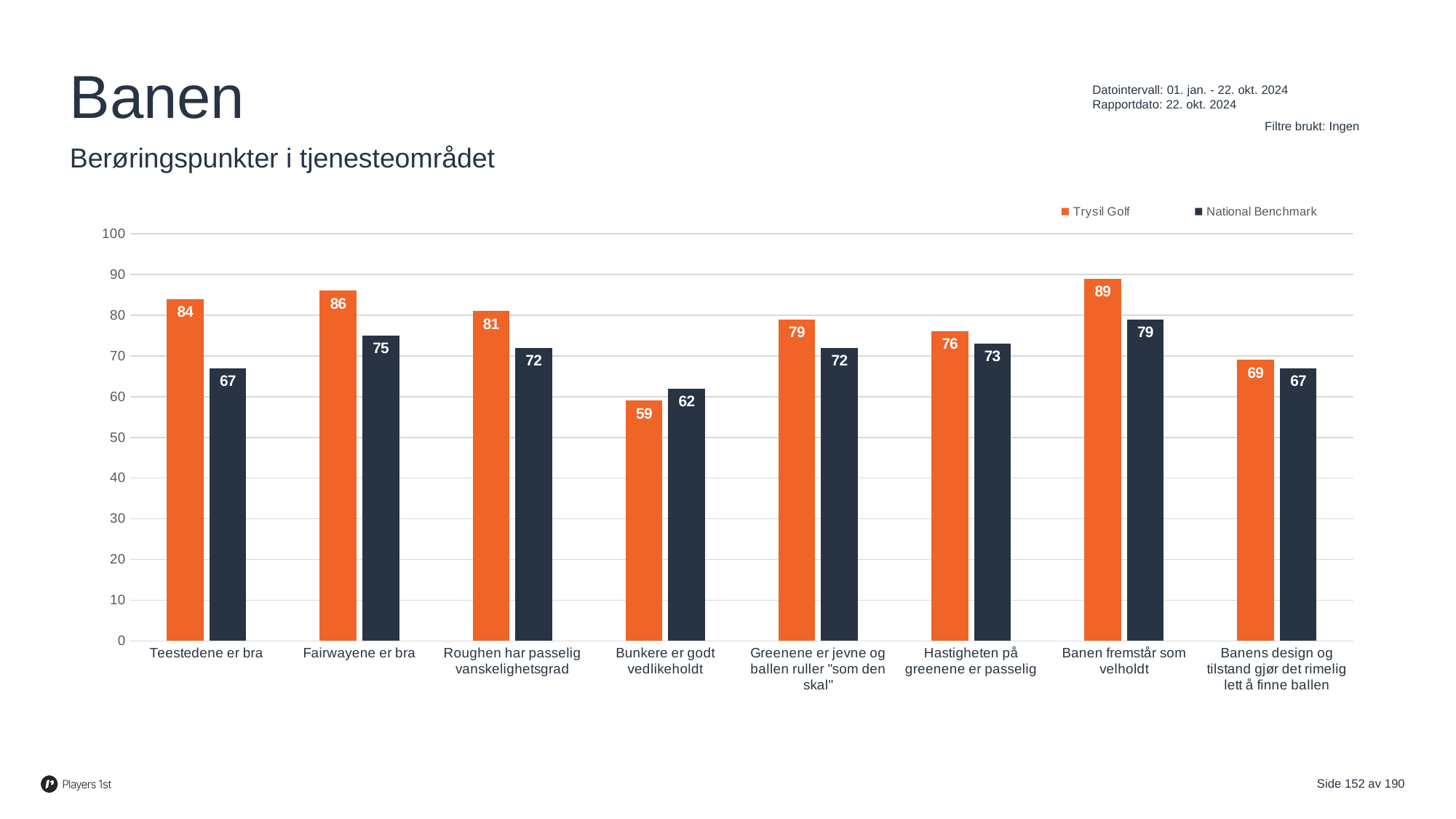
What is the difference between the Trysil Golf and National Benchmark values for "Teestedene er bra"? 17 Is the Trysil Golf value for "Roughen har passelig vanskelighetsgrad" greater or less than 80? greater How many categories are shown on the x axis? 8 What kind of chart is shown on the slide? bar chart Which series is shown in orange? Trysil Golf Which category has the lowest National Benchmark value? Bunkere er godt vedlikeholdt How many series does the legend list? 2 What is the Trysil Golf value for "Fairwayene er bra"? 86 For "Bunkere er godt vedlikeholdt", which is larger: Trysil Golf or National Benchmark? National Benchmark What is the National Benchmark value for "Bunkere er godt vedlikeholdt"? 62 What is the Trysil Golf value for "Banens design og tilstand gjør det rimelig lett å finne ballen"? 69 Which category has the highest Trysil Golf value? Banen fremstår som velholdt